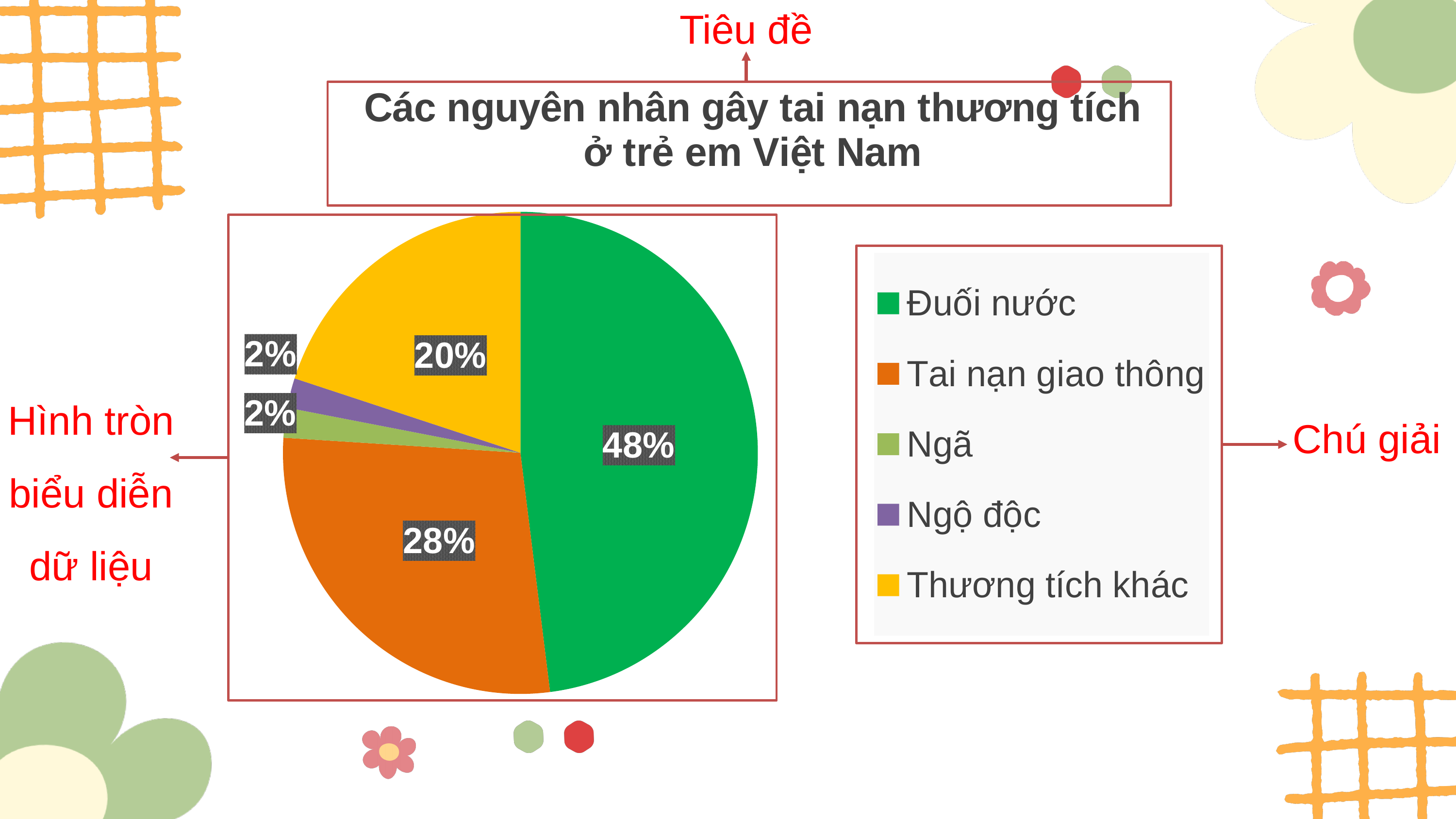
What percentage of the pie is Ngã? 2% What kind of chart is shown on the slide? pie chart What percentage of the pie is Đuối nước? 48% How many categories does the legend list? 5 Which category has the largest slice of the pie? Đuối nước What percentage of the pie is Thương tích khác? 20% What percentage of the pie is Tai nạn giao thông? 28% What colour is the Thương tích khác slice? yellow What percentage of the pie is Ngộ độc? 2% What is the title of the chart? Các nguyên nhân gây tai nạn thương tích ở trẻ em Việt Nam What is the difference between the Đuối nước and Tai nạn giao thông shares? 20% Which is larger, the share for Tai nạn giao thông or the share for Thương tích khác? Tai nạn giao thông